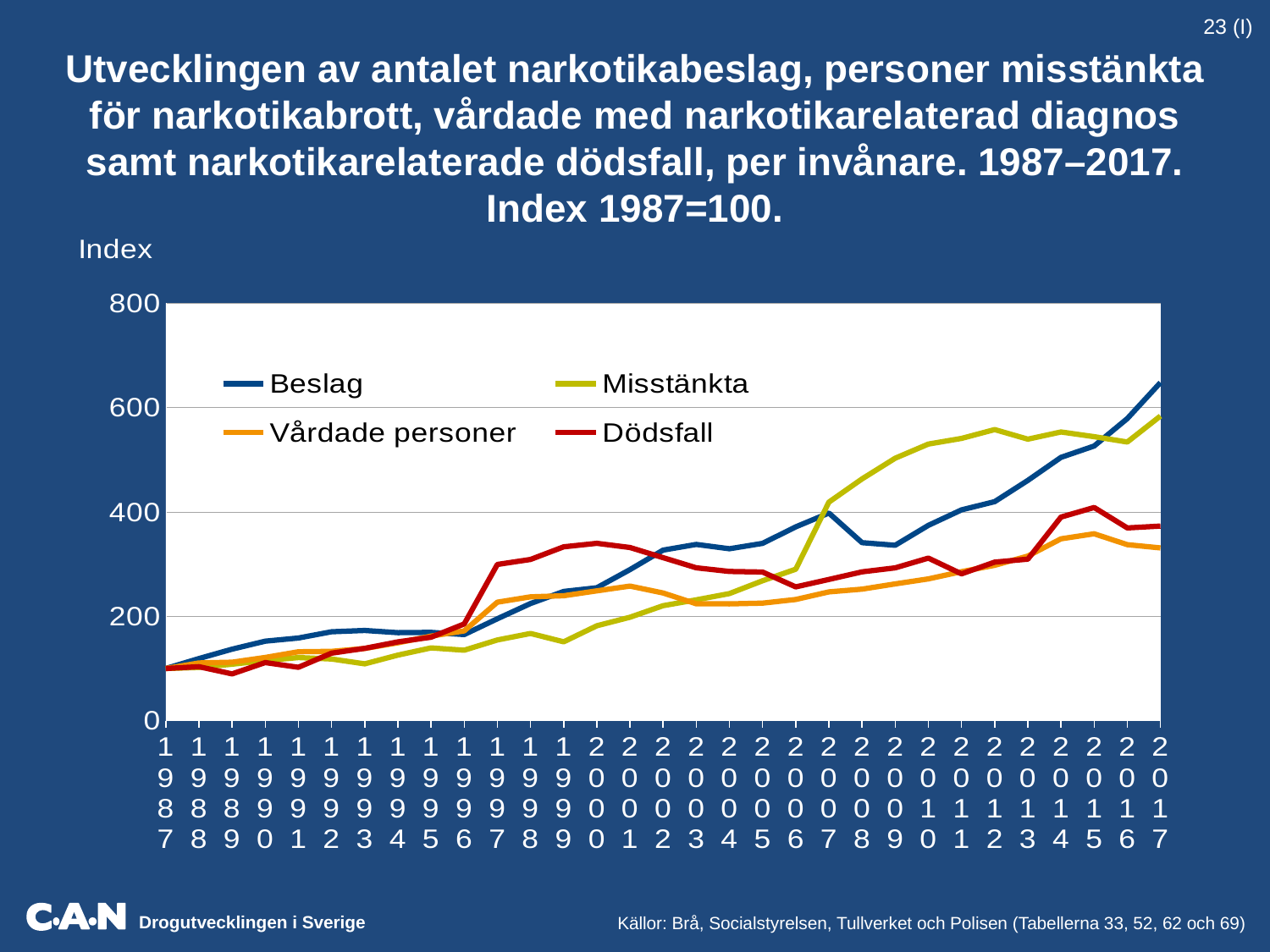
Does the Beslag series generally rise or fall from 1987 to 2017? rise Which series has the highest value in 2017? Beslag What kind of chart is shown on the slide? line chart Is the value for Misstänkta in 2012 greater or less than 400? greater Is the value for Dödsfall in 2017 greater or less than 400? less In 2017, which is larger: Misstänkta or Vårdade personer? Misstänkta How many years are plotted along the x axis? 31 Which series has the lowest value in 2017? Vårdade personer Is the value for Beslag in 2017 greater or less than 600? greater What is the index value of every series in 1987? 100 What label is shown on the y axis? Index How many series does the legend list? 4